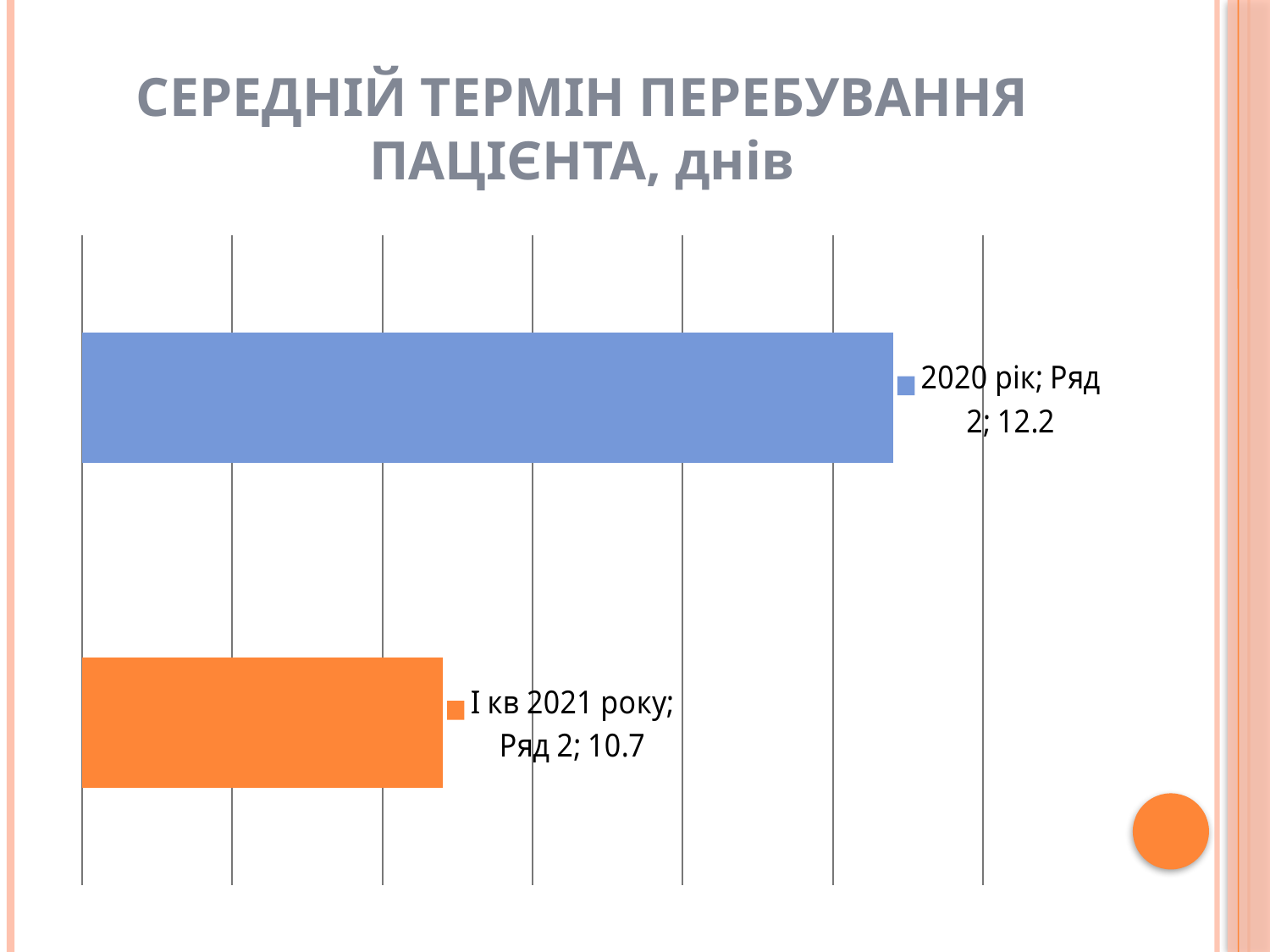
Which category has the highest value? 2020 рік Which is larger, the value for 2020 рік or the value for I кв 2021 року? 2020 рік What is the value shown for I кв 2021 року? 10.7 What is the title of the chart? СЕРЕДНІЙ ТЕРМІН ПЕРЕБУВАННЯ ПАЦІЄНТА, днів Did the average length of stay rise or fall from 2020 рік to I кв 2021 року? fall What is the average length of stay for 2020 рік? 12.2 What colour is the bar for I кв 2021 року? orange What kind of chart is shown on the slide? bar chart What is the difference between the value for 2020 рік and the value for I кв 2021 року? 1.5 Which category has the lowest value? I кв 2021 року How many bars are plotted on the chart? 2